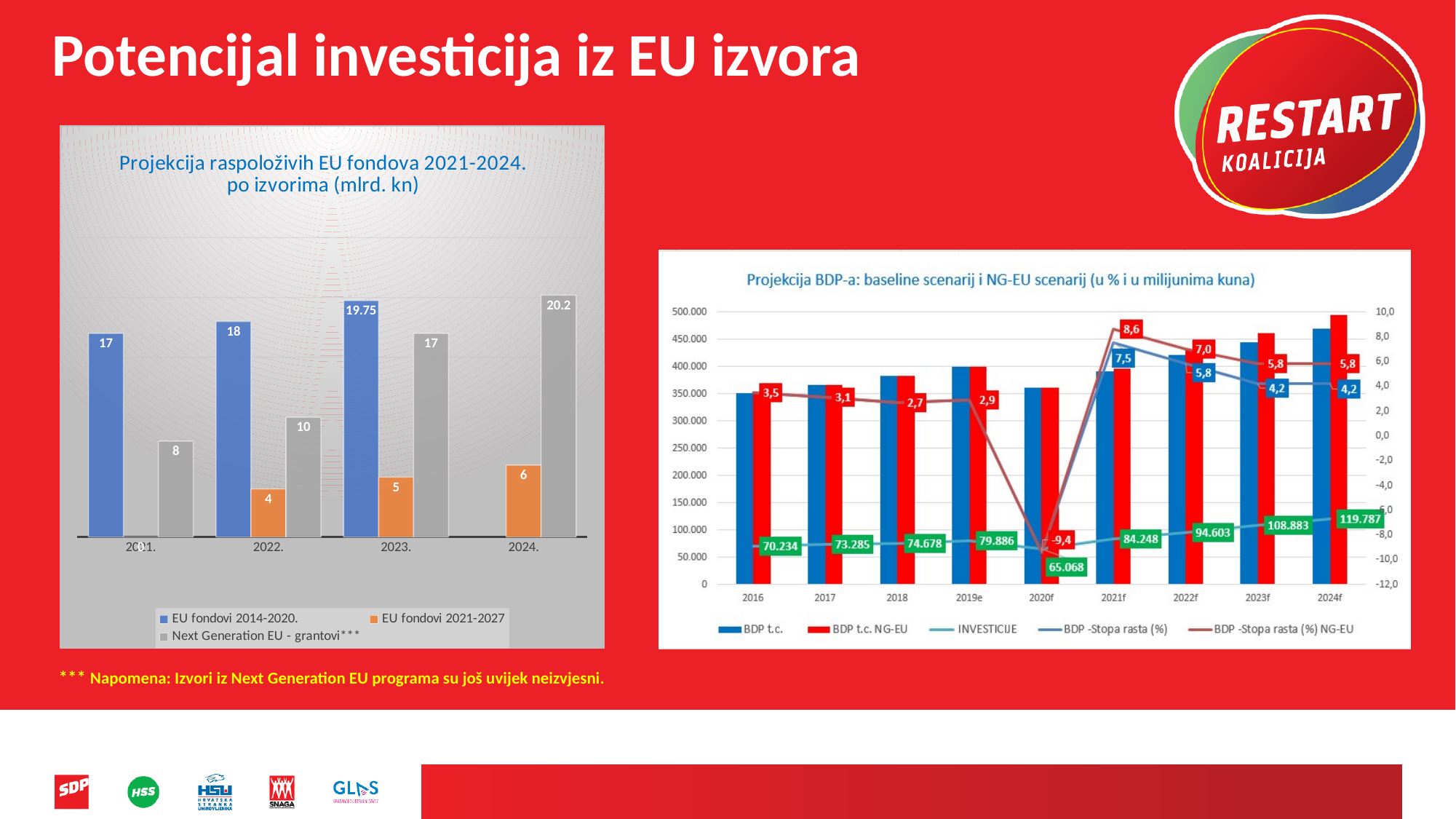
In the chart 'Projekcija BDP-a: baseline scenarij i NG-EU scenarij', what is the INVESTICIJE value for 2024f? 119.787 In the chart 'Projekcija BDP-a: baseline scenarij i NG-EU scenarij', in which year is the INVESTICIJE value lowest? 2020f In the chart 'Projekcija raspoloživih EU fondova 2021-2024. po izvorima (mlrd. kn)', what is the difference between the Next Generation EU - grantovi values for 2024. and 2023.? 3.2 What kind of chart is 'Projekcija raspoloživih EU fondova 2021-2024. po izvorima (mlrd. kn)'? Bar chart In the chart 'Projekcija raspoloživih EU fondova 2021-2024. po izvorima (mlrd. kn)', which is larger in 2022.: EU fondovi 2014-2020. or Next Generation EU - grantovi? EU fondovi 2014-2020. How many years are shown on the x axis of the chart 'Projekcija BDP-a: baseline scenarij i NG-EU scenarij'? 9 How many series does the legend of the chart 'Projekcija raspoloživih EU fondova 2021-2024. po izvorima (mlrd. kn)' list? 3 In the chart 'Projekcija raspoloživih EU fondova 2021-2024. po izvorima (mlrd. kn)', what is the value for EU fondovi 2014-2020. in 2023.? 19.75 In the chart 'Projekcija raspoloživih EU fondova 2021-2024. po izvorima (mlrd. kn)', what is the value for Next Generation EU - grantovi in 2024.? 20.2 In the chart 'Projekcija raspoloživih EU fondova 2021-2024. po izvorima (mlrd. kn)', in which year is the Next Generation EU - grantovi value highest? 2024. In the chart 'Projekcija BDP-a: baseline scenarij i NG-EU scenarij', what is the BDP -Stopa rasta (%) NG-EU value for 2021f? 8,6 How many series does the legend of the chart 'Projekcija BDP-a: baseline scenarij i NG-EU scenarij' list? 5